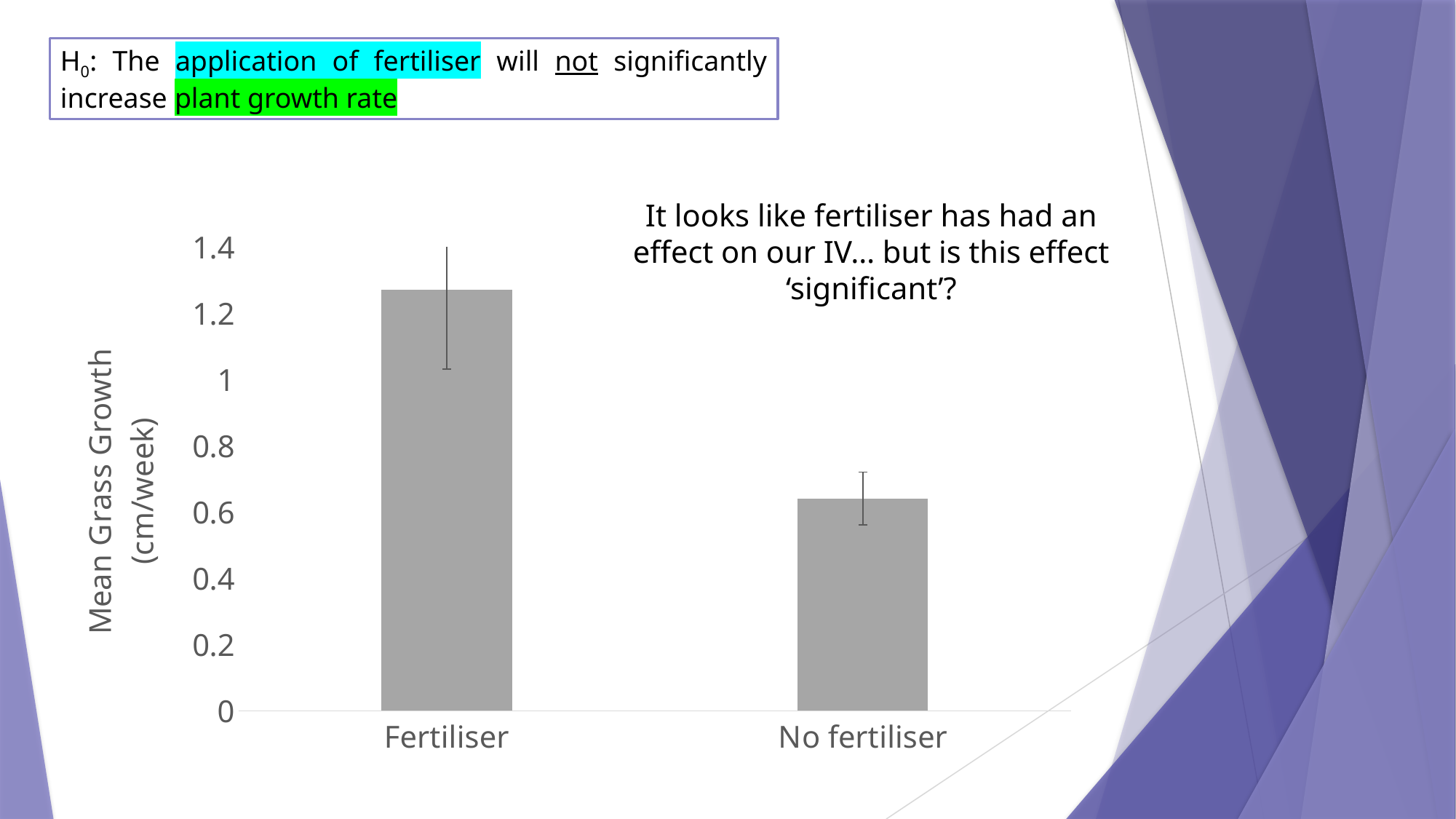
Is the value for No fertiliser greater or less than 0.8? less Which category has the lowest mean grass growth? No fertiliser Is the value for Fertiliser greater or less than 1? greater Is the value for Fertiliser greater or less than 1.4? less What colour are the bars in the chart? grey What is the label on the y axis of the chart? Mean Grass Growth (cm/week) Which is larger, the mean grass growth for Fertiliser or for No fertiliser? Fertiliser How many categories are plotted on the x axis of the chart? 2 Which category has the highest mean grass growth? Fertiliser What kind of chart is shown on the slide? bar chart